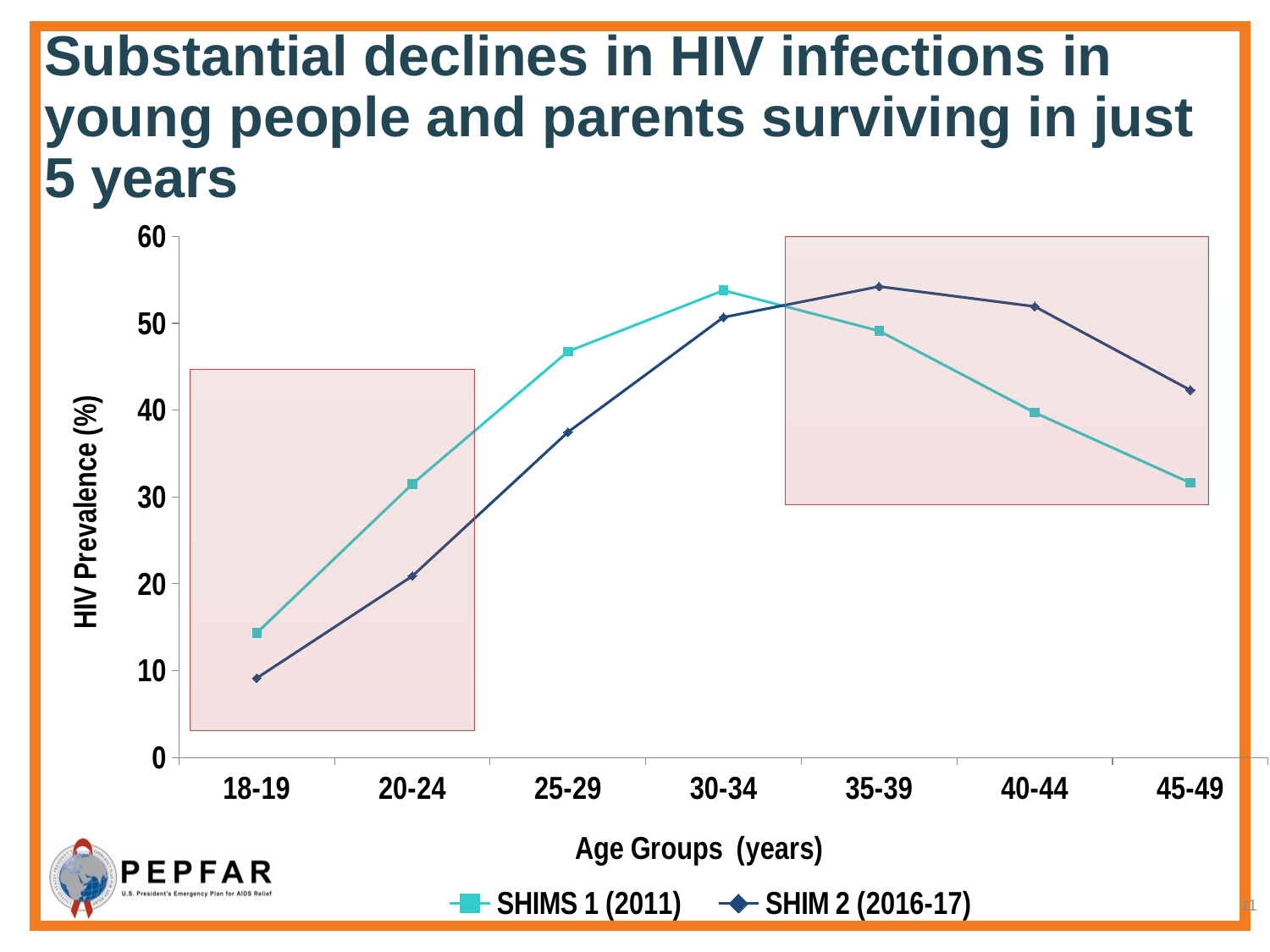
How many series does the legend list? 2 How many age groups are plotted along the x axis? 7 Which age group has the highest HIV prevalence for SHIMS 1 (2011)? 30-34 Does the SHIMS 1 (2011) line rise or fall from the 30-34 age group to the 45-49 age group? Fall What kind of chart is shown on the slide? Line chart Which age group has the lowest HIV prevalence for SHIMS 1 (2011)? 18-19 What is the label of the y axis? HIV Prevalence (%) For the 40-44 age group, which series has the higher HIV prevalence, SHIMS 1 (2011) or SHIM 2 (2016-17)? SHIM 2 (2016-17) Is the SHIMS 1 (2011) value for the 25-29 age group greater or less than 40? greater Is the SHIM 2 (2016-17) value for the 18-19 age group greater or less than 10? less Which age group has the lowest HIV prevalence for SHIM 2 (2016-17)? 18-19 For the 20-24 age group, which series has the higher HIV prevalence, SHIMS 1 (2011) or SHIM 2 (2016-17)? SHIMS 1 (2011)